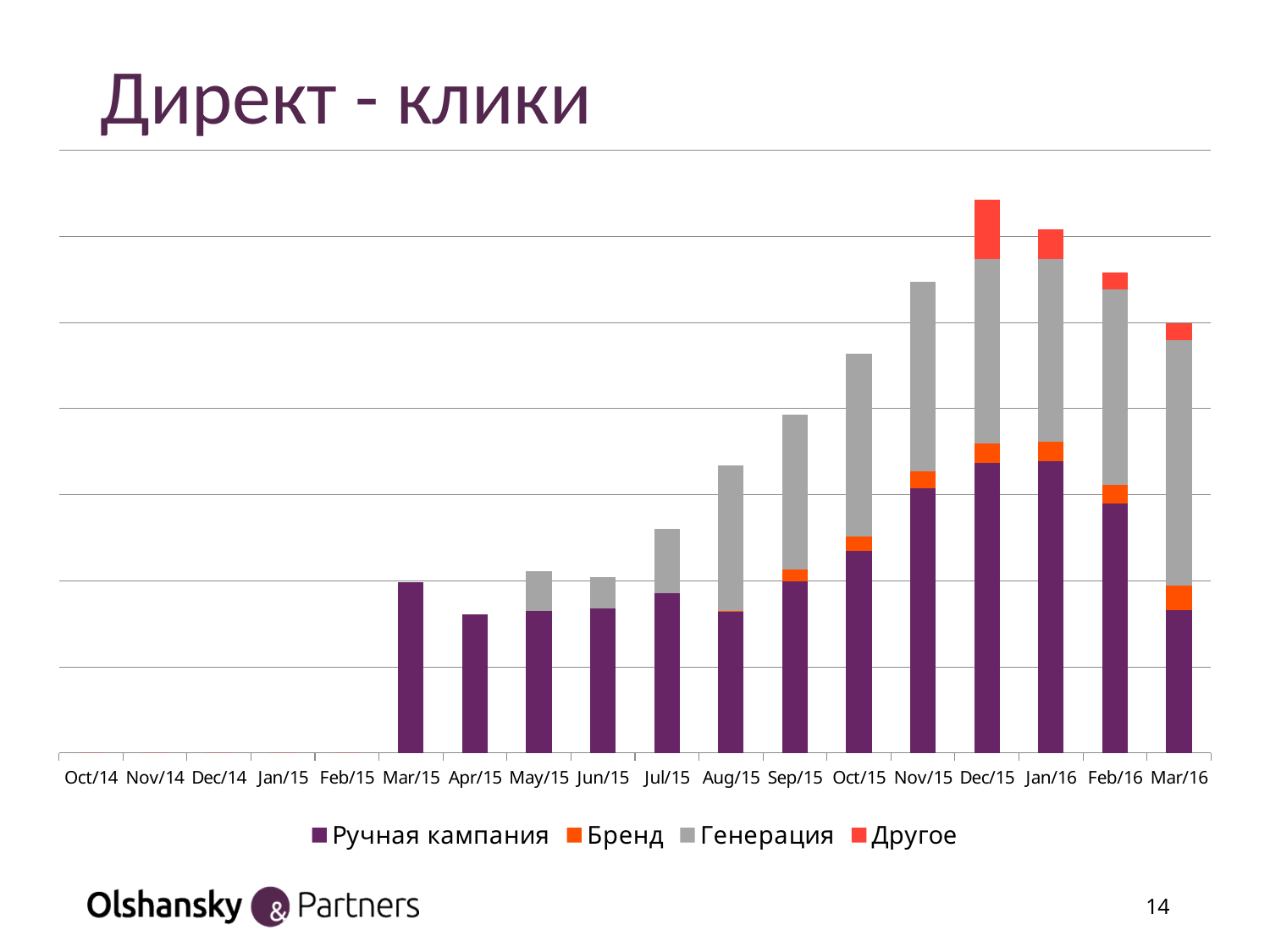
Which month has the tallest stacked bar? Dec/15 How many months are labelled on the x axis? 18 Is the total bar for Dec/15 larger or smaller than the total bar for Mar/16? larger Among the months that have a bar, which has the shortest total bar? Apr/15 How many series does the legend list? 4 Which is the first month on the x axis that has a bar? Mar/15 In which month does the 'Другое' series first appear in the bars? Dec/15 Do the total bar heights rise or fall from Dec/15 to Mar/16? fall Do the total bar heights rise or fall from Mar/15 to Dec/15? rise Is the total bar for Sep/15 larger or smaller than the total bar for Aug/15? larger Which series forms the bottom segment of each stacked bar? Ручная кампания What kind of chart is shown on the slide? Stacked bar chart